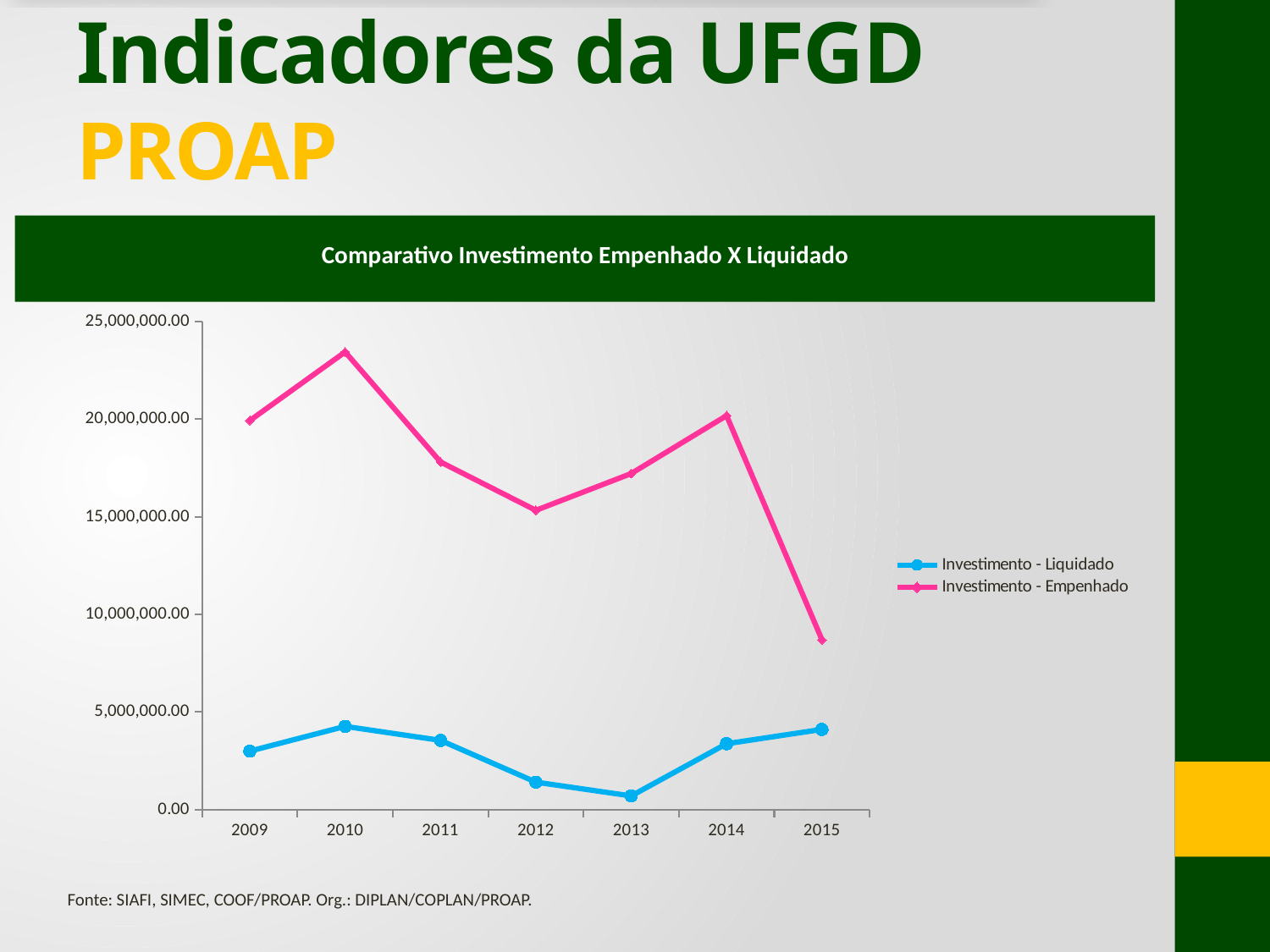
Is the value for Investimento - Empenhado in 2015 greater or less than 10,000,000.00? less What kind of chart is shown on the slide? line chart Is the value for Investimento - Empenhado in 2010 greater or less than 20,000,000.00? greater Is the value for Investimento - Liquidado in 2010 greater or less than 5,000,000.00? less What is the title of the chart? Comparativo Investimento Empenhado X Liquidado How many series does the legend list? 2 In which year is Investimento - Empenhado lowest? 2015 Does Investimento - Empenhado rise or fall from 2014 to 2015? fall How many years are shown on the x axis? 7 Which is larger for Investimento - Empenhado: the value in 2011 or the value in 2014? 2014 In which year is Investimento - Empenhado highest? 2010 In which year is Investimento - Liquidado lowest? 2013